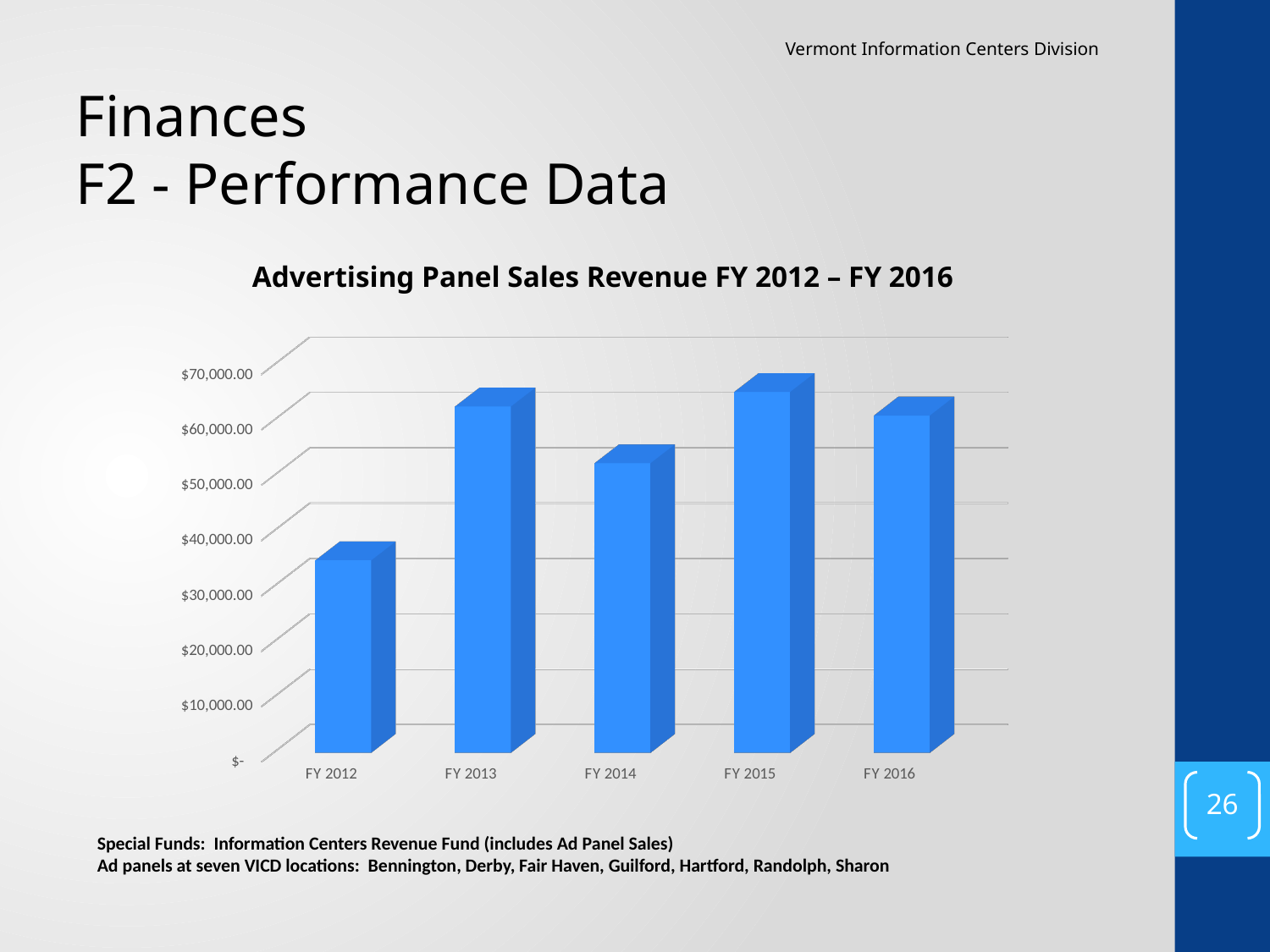
What kind of chart is shown on the slide? Bar chart How many fiscal years are shown on the x axis of the chart? 5 Which is larger, the revenue for FY 2013 or FY 2014? FY 2013 What is the title of the chart? Advertising Panel Sales Revenue FY 2012 – FY 2016 Which fiscal year has the lowest advertising panel sales revenue? FY 2012 Which fiscal year has the highest advertising panel sales revenue? FY 2015 Is the value for FY 2015 greater or less than $60,000.00? greater Which is larger, the revenue for FY 2016 or FY 2012? FY 2016 Is the value for FY 2012 greater or less than $40,000.00? less Is the value for FY 2014 greater or less than $60,000.00? less Does the revenue rise or fall from FY 2015 to FY 2016? Fall